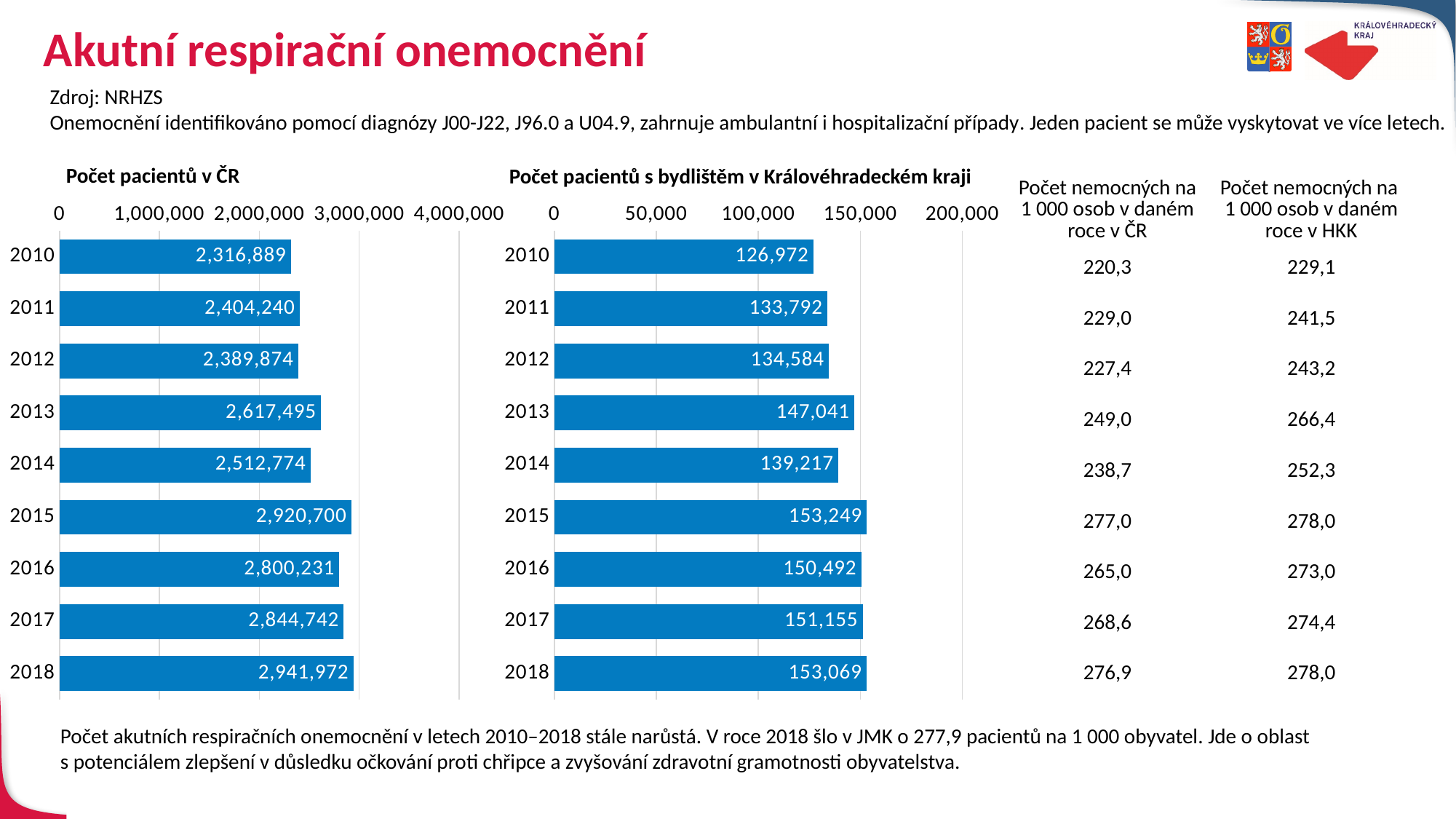
In the chart 'Počet pacientů v ČR', which year has the highest value? 2018 What kind of chart is 'Počet pacientů v ČR'? bar chart In the chart 'Počet pacientů v ČR', what is the value for 2015? 2,920,700 In the chart 'Počet pacientů s bydlištěm v Královéhradeckém kraji', what is the difference between the values for 2015 and 2014? 14,032 How many years are shown in the chart 'Počet pacientů s bydlištěm v Královéhradeckém kraji'? 9 In the chart 'Počet pacientů v ČR', is the value for 2014 greater or less than 3,000,000? less In the chart 'Počet pacientů v ČR', which is larger, the value for 2011 or the value for 2012? 2011 In the chart 'Počet pacientů s bydlištěm v Královéhradeckém kraji', what is the value for 2018? 153,069 In the chart 'Počet pacientů v ČR', what is the difference between the values for 2018 and 2010? 625,083 In the chart 'Počet pacientů s bydlištěm v Královéhradeckém kraji', which year has the highest value? 2015 In the chart 'Počet pacientů s bydlištěm v Královéhradeckém kraji', what is the value for 2013? 147,041 In the chart 'Počet pacientů s bydlištěm v Královéhradeckém kraji', which year has the lowest value? 2010